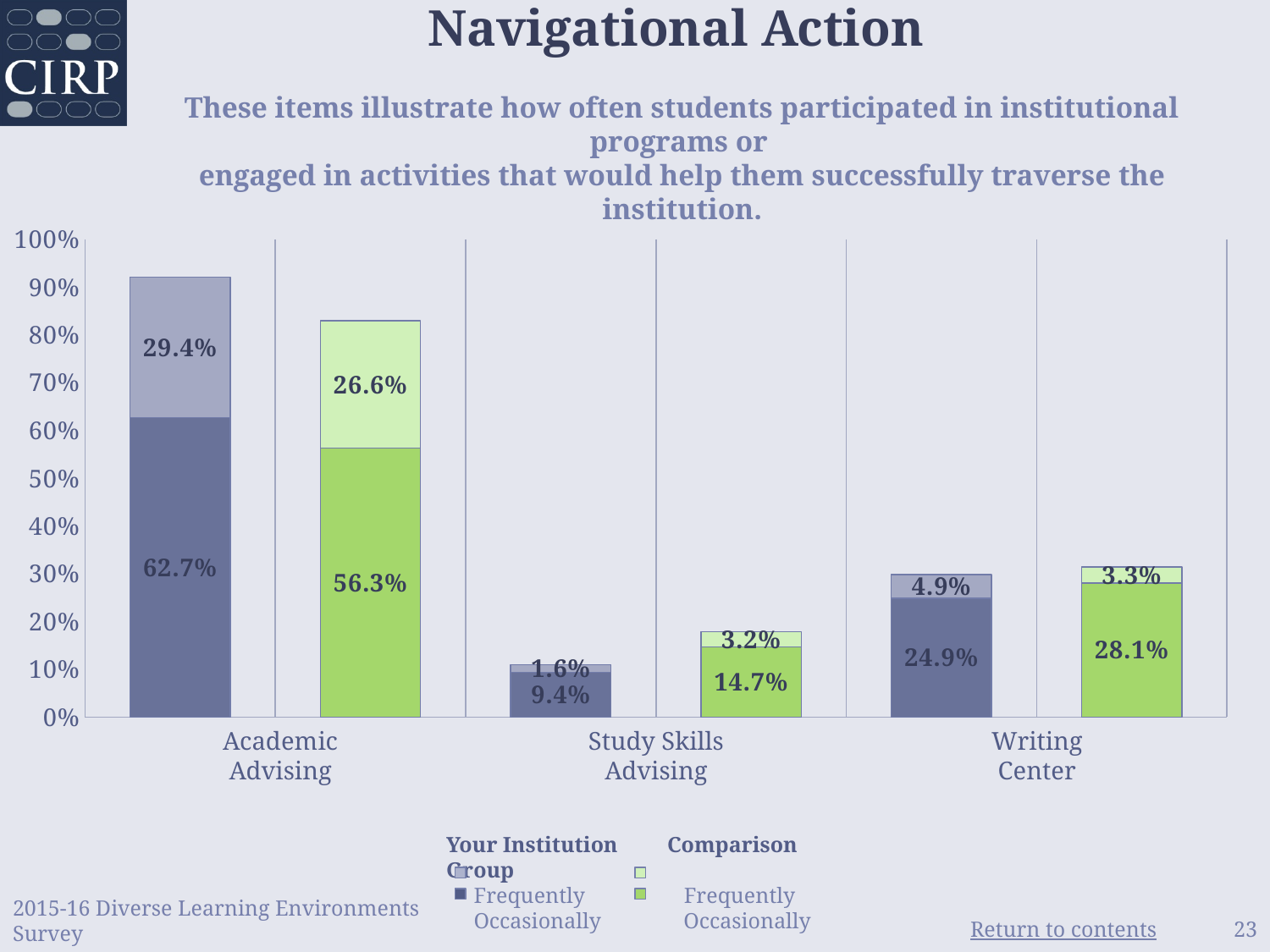
Which category has the highest 'Frequently' value for Your Institution? Academic Advising What is the title of the chart on the slide? Navigational Action What is the Comparison Group's 'Occasionally' value for Study Skills Advising? 14.7% What kind of chart is shown on the slide? Stacked bar chart What is the total height of the Your Institution stacked bar for Academic Advising? 92.1% What is the 'Frequently' value for the Writing Center in the Comparison Group? 3.3% For the Writing Center, which is larger: Your Institution's 'Frequently' value or the Comparison Group's 'Frequently' value? Your Institution What percentage of students at Your Institution reported frequently using Academic Advising? 29.4% What is the difference between Your Institution's and the Comparison Group's 'Frequently' values for Academic Advising? 2.8% How many categories are shown on the x axis? 3 What is the total height of the Comparison Group stacked bar for Study Skills Advising? 17.9% Which category has the lowest 'Frequently' value for the Comparison Group? Study Skills Advising